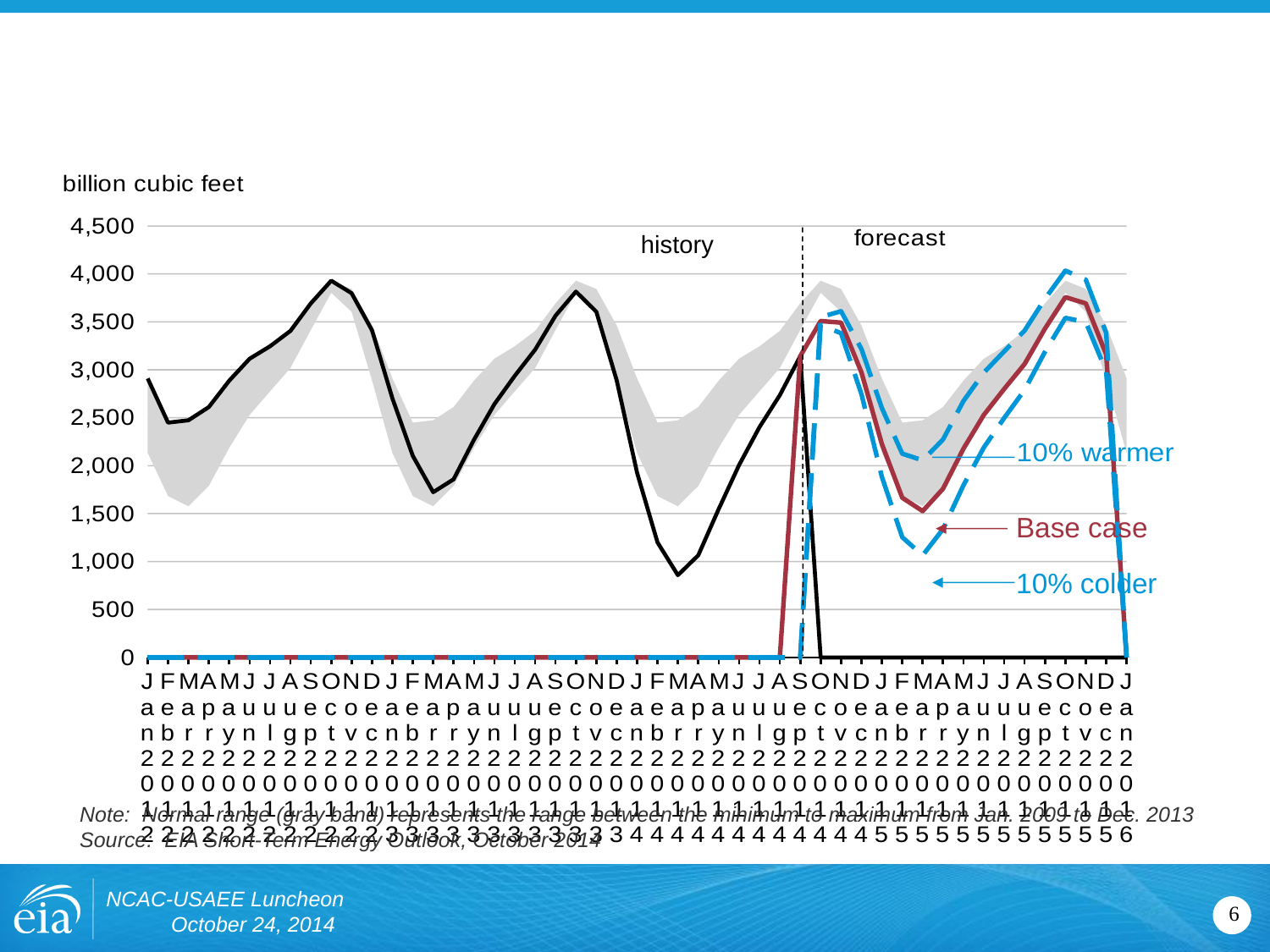
Which forecast scenario line reaches the highest peak in the forecast period? 10% warmer At their lowest points in the forecast period, which is higher: the 10% warmer line or the Base case line? 10% warmer What unit is shown on the y axis of the chart? billion cubic feet Does the history line rise or fall from its late-2012 peak to early 2013? fall Is the lowest point of the history line in early 2014 greater or less than 1,000? less What is the highest value labeled on the y axis of the chart? 4,500 What kind of chart is shown on the slide? line chart Is the lowest point of the 10% colder line in the forecast period greater or less than 1,500? less Is the peak of the history line in late 2012 greater or less than 3,500? greater Which forecast scenario line reaches the lowest point in the forecast period? 10% colder How many forecast scenario lines are labeled on the chart? 3